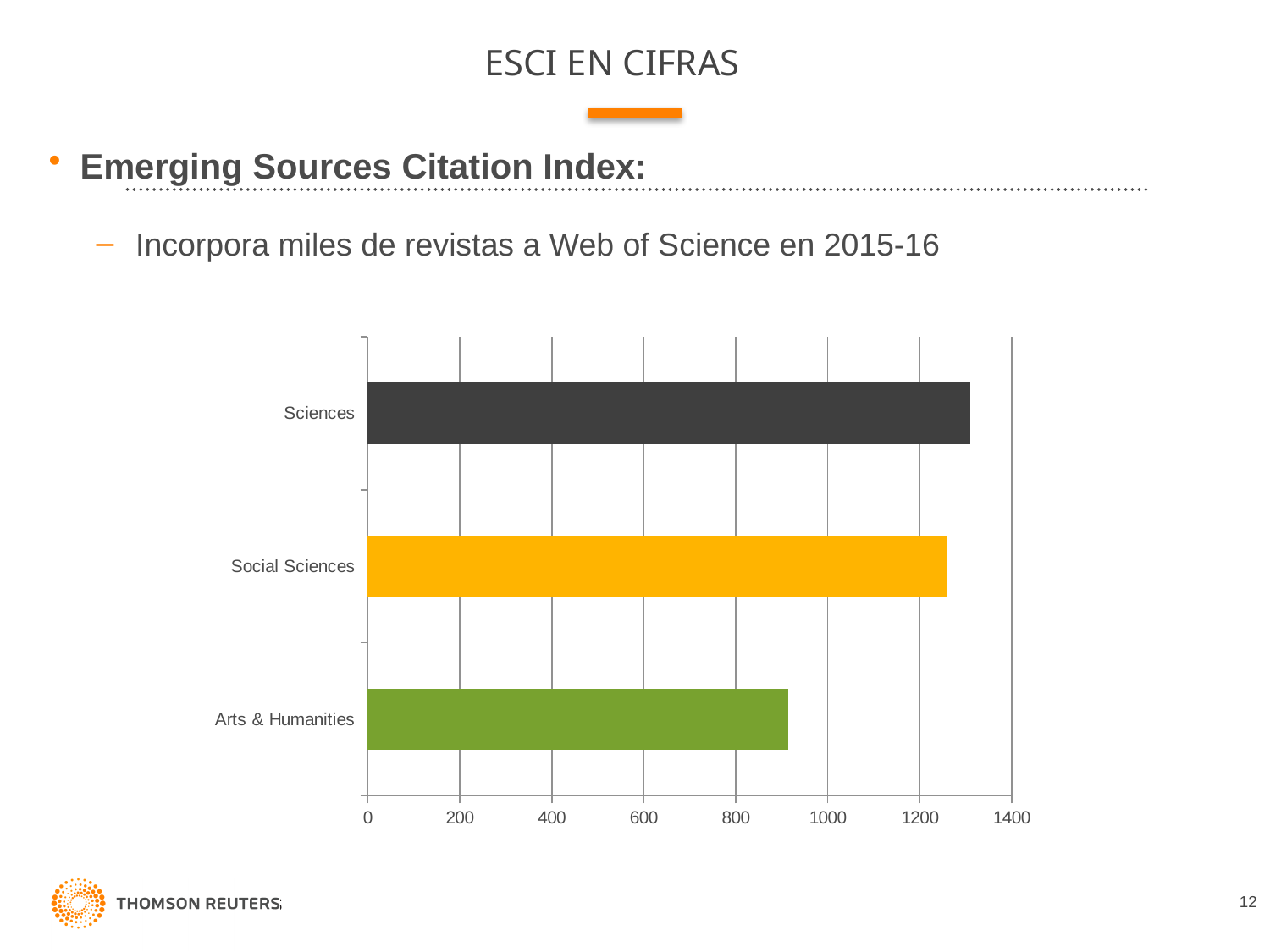
Is the value for Arts & Humanities greater or less than 1000? less What colour is the bar for Arts & Humanities? green Is the value for Sciences greater or less than 1200? greater Is the value for Sciences greater or less than 1400? less Which is larger, the value for Social Sciences or the value for Arts & Humanities? Social Sciences What kind of chart is shown on the slide? bar chart How many categories are plotted in the chart? 3 What is the highest value shown on the horizontal axis of the chart? 1400 Which category has the highest value in the chart? Sciences Which category has the lowest value in the chart? Arts & Humanities